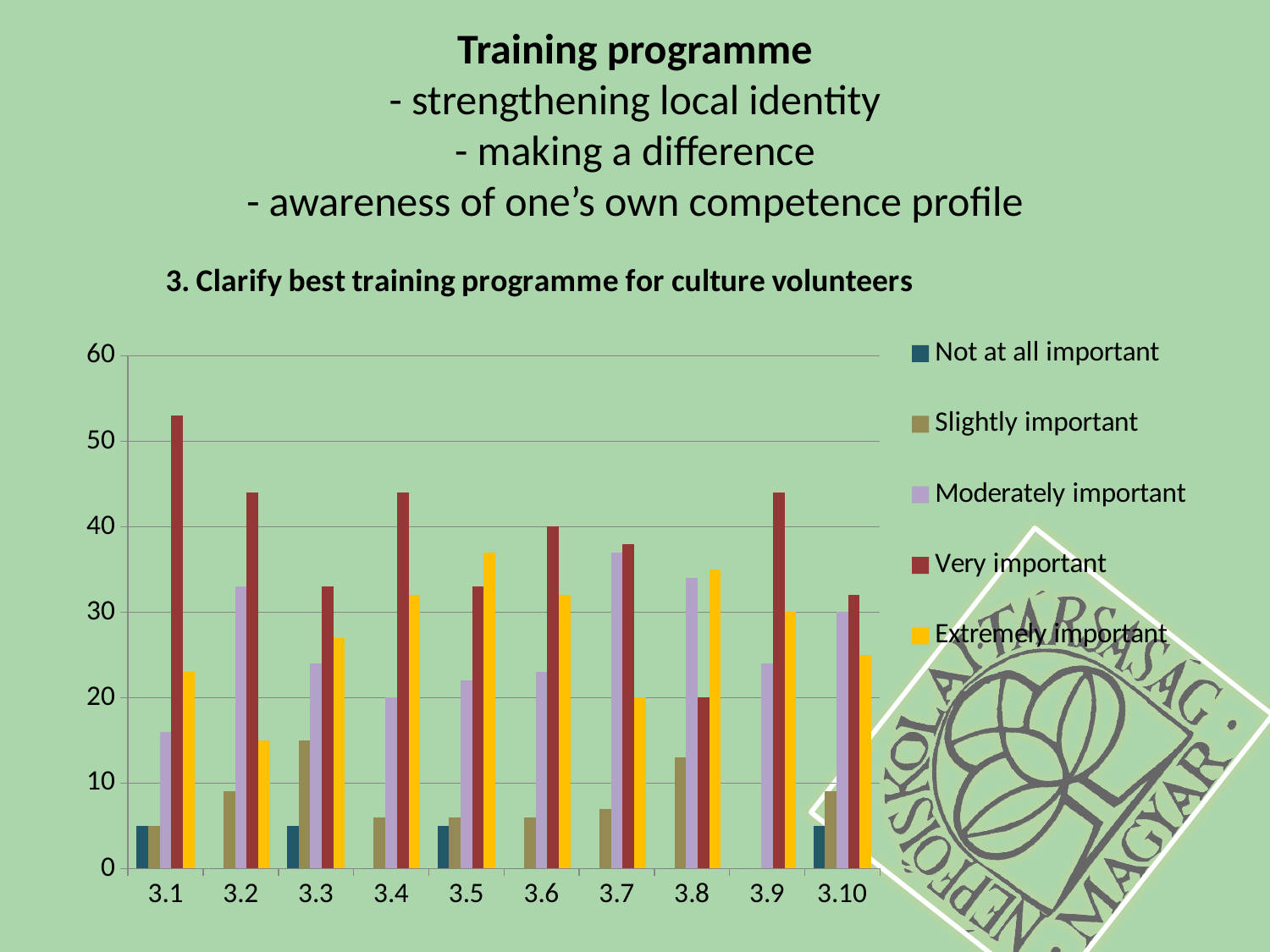
Which category has the highest 'Very important' bar? 3.1 Is the 'Extremely important' value for 3.2 greater or less than 20? less What is the title of the chart? 3. Clarify best training programme for culture volunteers How many categories are shown on the x axis of the chart? 10 Is the 'Very important' value for 3.1 greater or less than 50? greater Is the 'Slightly important' value for 3.3 greater or less than 10? greater What is the 'Very important' value for 3.6? 40 Which category has the lowest 'Very important' bar? 3.8 For category 3.8, which is larger: 'Extremely important' or 'Very important'? Extremely important What kind of chart is shown on the slide? bar chart How many series does the chart's legend list? 5